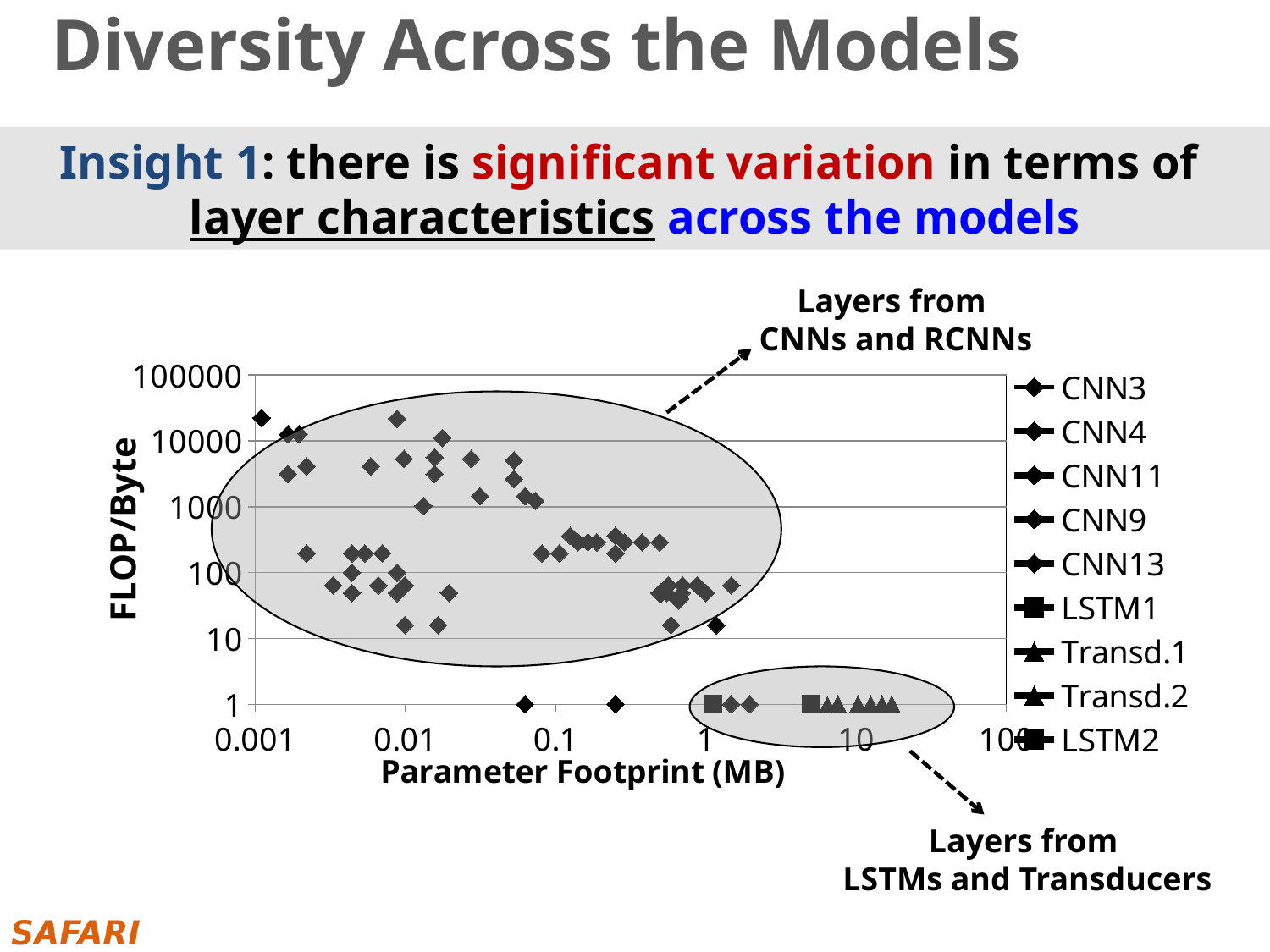
According to the annotation, which layers are in the lower ellipse of the chart? Layers from LSTMs and Transducers What kind of chart is shown on the slide? scatter chart Is the FLOP/Byte value of the highest CNN point greater or less than 10000? greater Which group of layers has the larger Parameter Footprint: the LSTM/Transducer layers or the CNN/RCNN layers? LSTM/Transducer layers Are the FLOP/Byte values of the Transd.1 and Transd.2 (triangle) points greater or less than 10? less What is the title of the x axis of the chart? Parameter Footprint (MB) How many of the legend entries are CNN series? 5 How many series does the chart's legend list? 9 Is the Parameter Footprint of the LSTM and Transducer points greater or less than 1 MB? greater Which group of layers has higher FLOP/Byte values: the CNN/RCNN layers or the LSTM/Transducer layers? CNN/RCNN layers